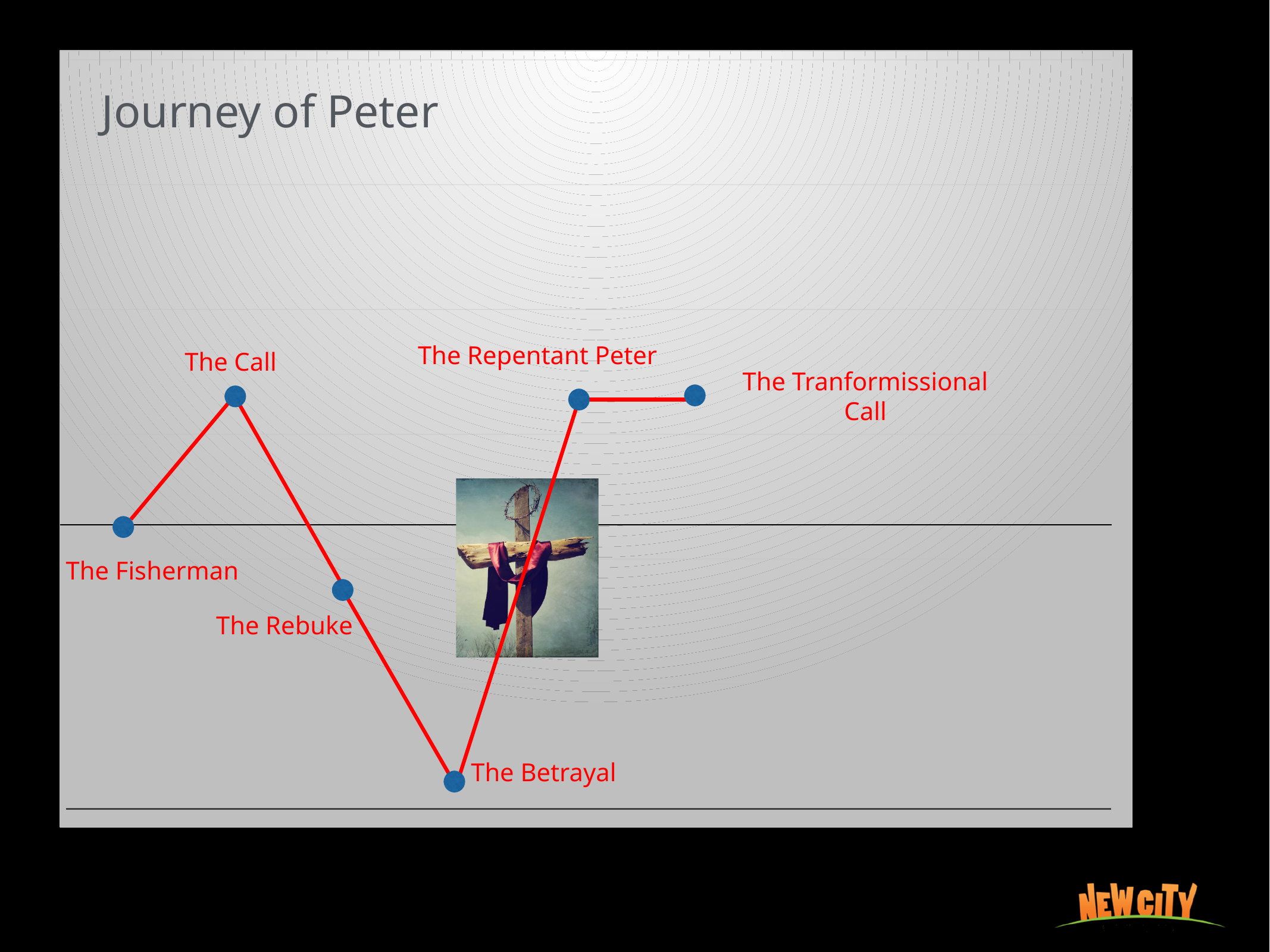
Which labelled point is the lowest on the chart? The Betrayal Does the line rise or fall from The Betrayal to The Repentant Peter? Rise Does the line rise, fall or stay flat from The Repentant Peter to The Tranformissional Call? Stay flat What is the title of the chart? Journey of Peter Which is plotted higher, The Call or The Rebuke? The Call Which labelled point is the first on the left of the line? The Fisherman Which is plotted higher, The Repentant Peter or The Rebuke? The Repentant Peter Does the line rise or fall from The Call to The Betrayal? Fall Which is plotted higher, The Fisherman or The Betrayal? The Fisherman What kind of chart is shown on the slide? Line chart Which labelled point comes immediately after The Rebuke along the line? The Betrayal How many labelled points are plotted on the line? 6